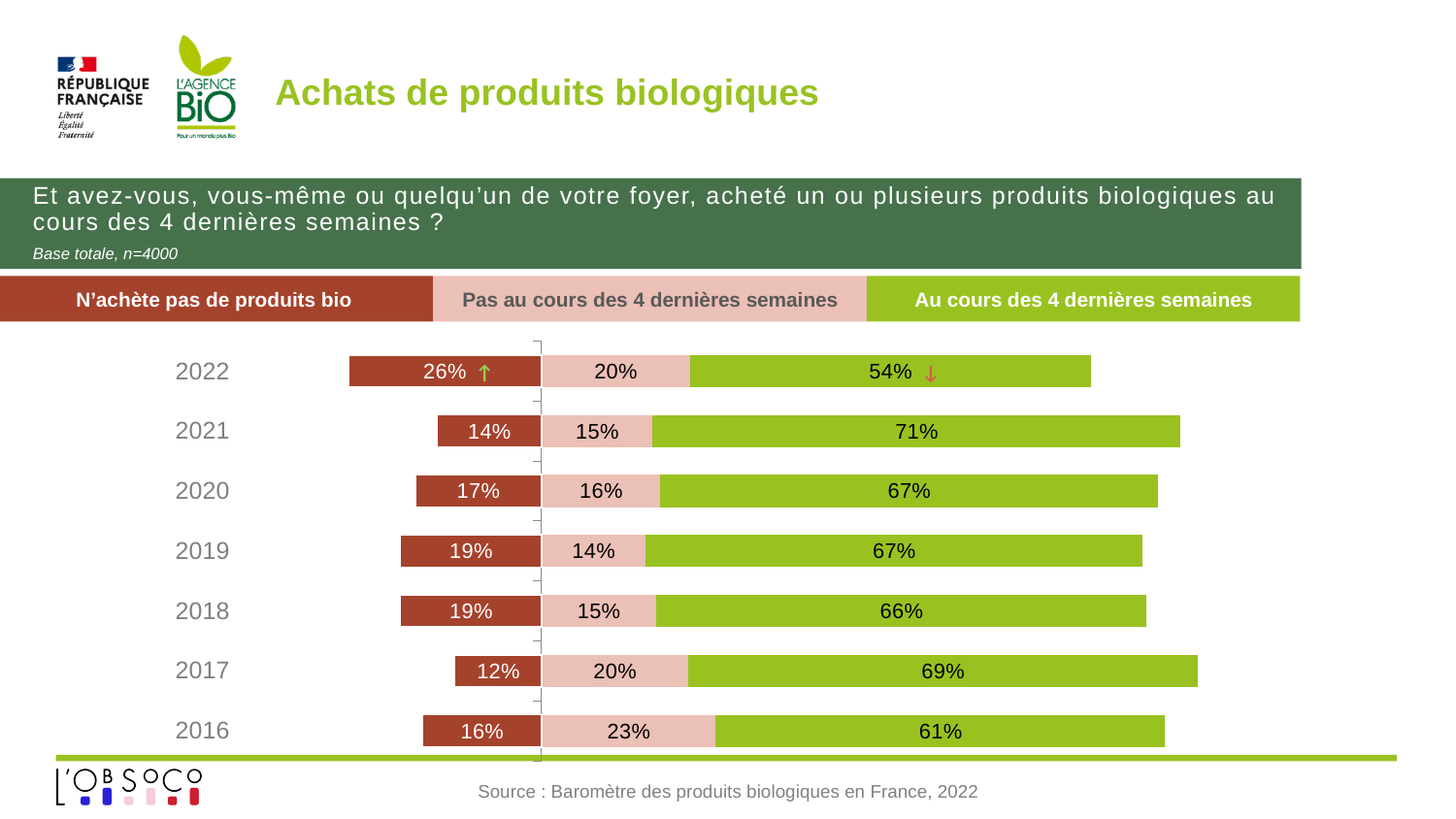
How many series does the legend list? 3 What is the difference between the "Au cours des 4 dernières semaines" values for 2021 and 2022? 17 percentage points Which year has the lowest value for "N'achète pas de produits bio"? 2017 What is the value for "N'achète pas de produits bio" in 2021? 14% How many years are shown in the chart? 7 Which year has the highest value for "Au cours des 4 dernières semaines"? 2021 What is the value for "Pas au cours des 4 dernières semaines" in 2016? 23% Which is larger: the "N'achète pas de produits bio" value in 2022 or in 2020? 2022 What is the total of the three segments for 2022? 100% What kind of chart is shown on the slide? stacked bar chart What is the value for "Au cours des 4 dernières semaines" in 2022? 54% Which series is shown in green in the chart? Au cours des 4 dernières semaines